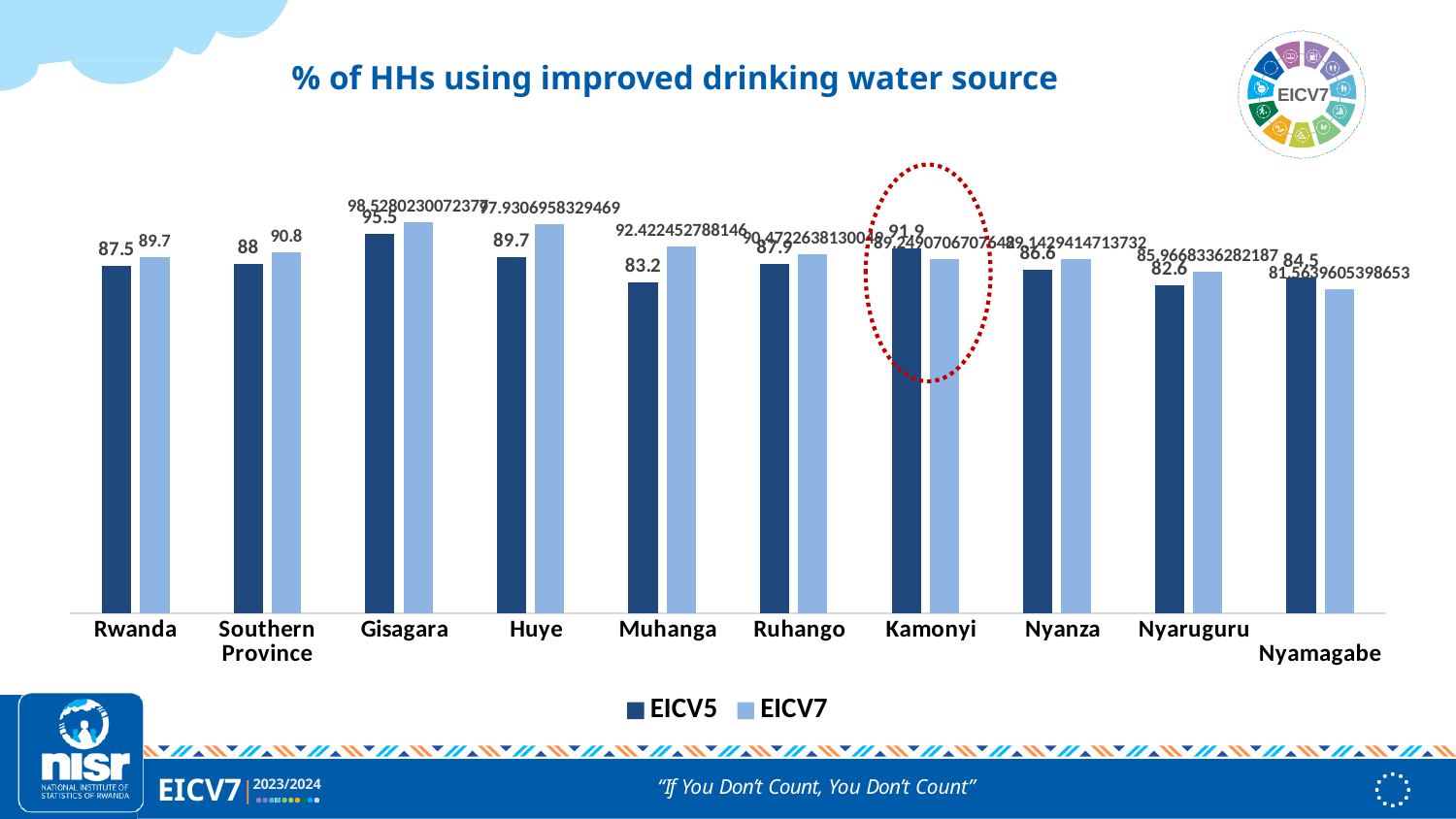
Which category has the lowest EICV5 value? Nyaruguru Which category is highlighted with a red dotted circle? Kamonyi Which category has the highest EICV5 value? Gisagara What kind of chart is shown on the slide? bar chart What is the EICV5 value for Muhanga? 83.2 Which has the larger EICV5 value, Kamonyi or Nyanza? Kamonyi How many categories are shown on the x axis? 10 What is the difference between the EICV7 and EICV5 values for Southern Province? 2.8 How many series does the legend list? 2 What is the difference between the EICV7 and EICV5 values for Rwanda? 2.2 What is the EICV5 value for Rwanda? 87.5 What is the EICV7 value for Southern Province? 90.8